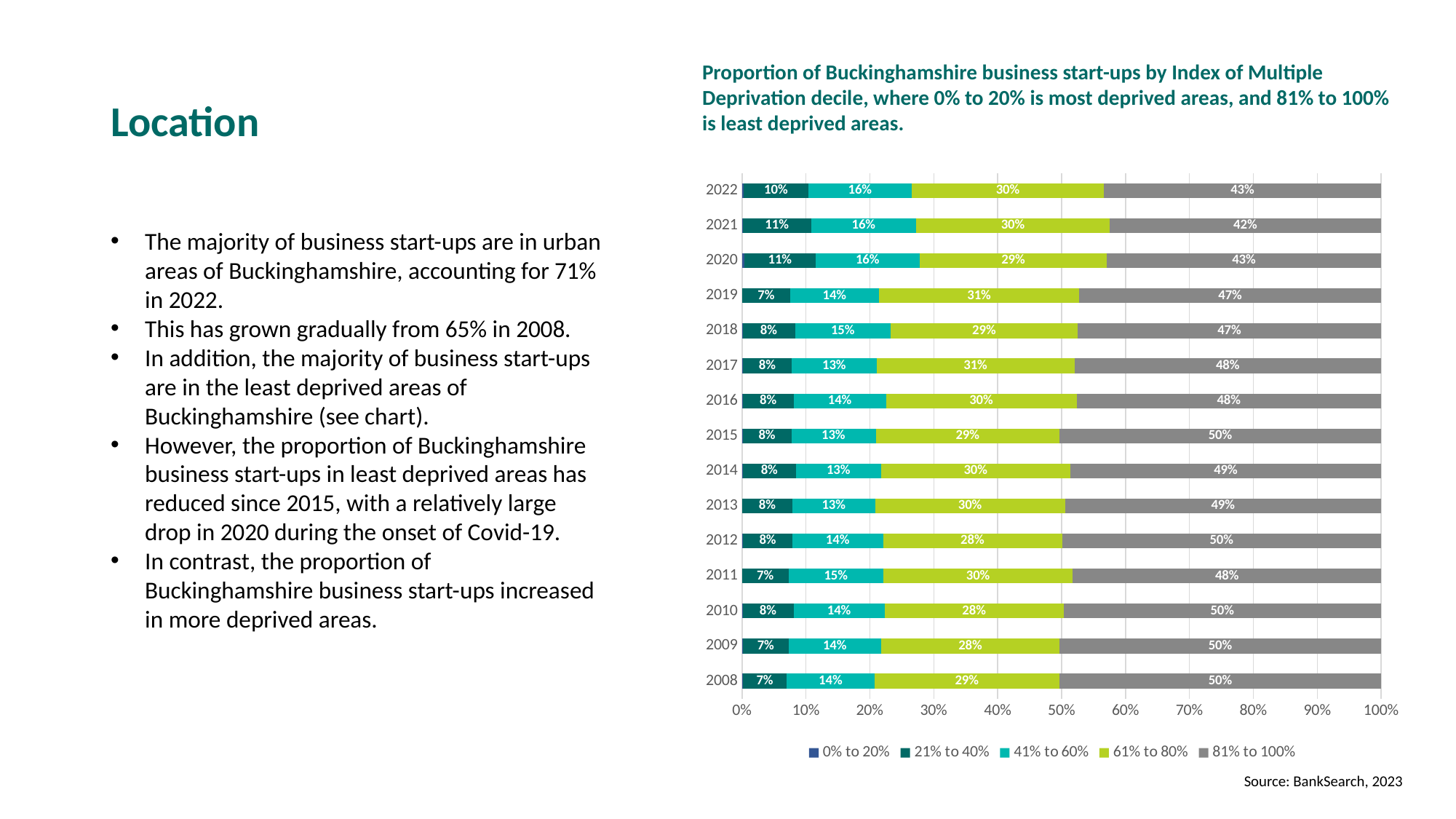
Which year has the larger share in the 21% to 40% decile, 2008 or 2022? 2022 What is the value for the 61% to 80% decile in 2019? 31% Does the share of start-ups in the 81% to 100% decile generally rise or fall from 2008 to 2022? Fall What is the value for the 21% to 40% decile in 2021? 11% How many series does the legend list? 5 How many years are shown on the chart? 15 What is the value for the 41% to 60% decile in 2008? 14% What proportion of business start-ups in 2022 were in the 81% to 100% decile? 43% Which legend entry is shown in grey? 81% to 100% What kind of chart is shown on the slide? Stacked bar chart In which year is the 81% to 100% decile share lowest? 2021 By how many percentage points did the 81% to 100% decile share fall from 2008 to 2022? 7 percentage points